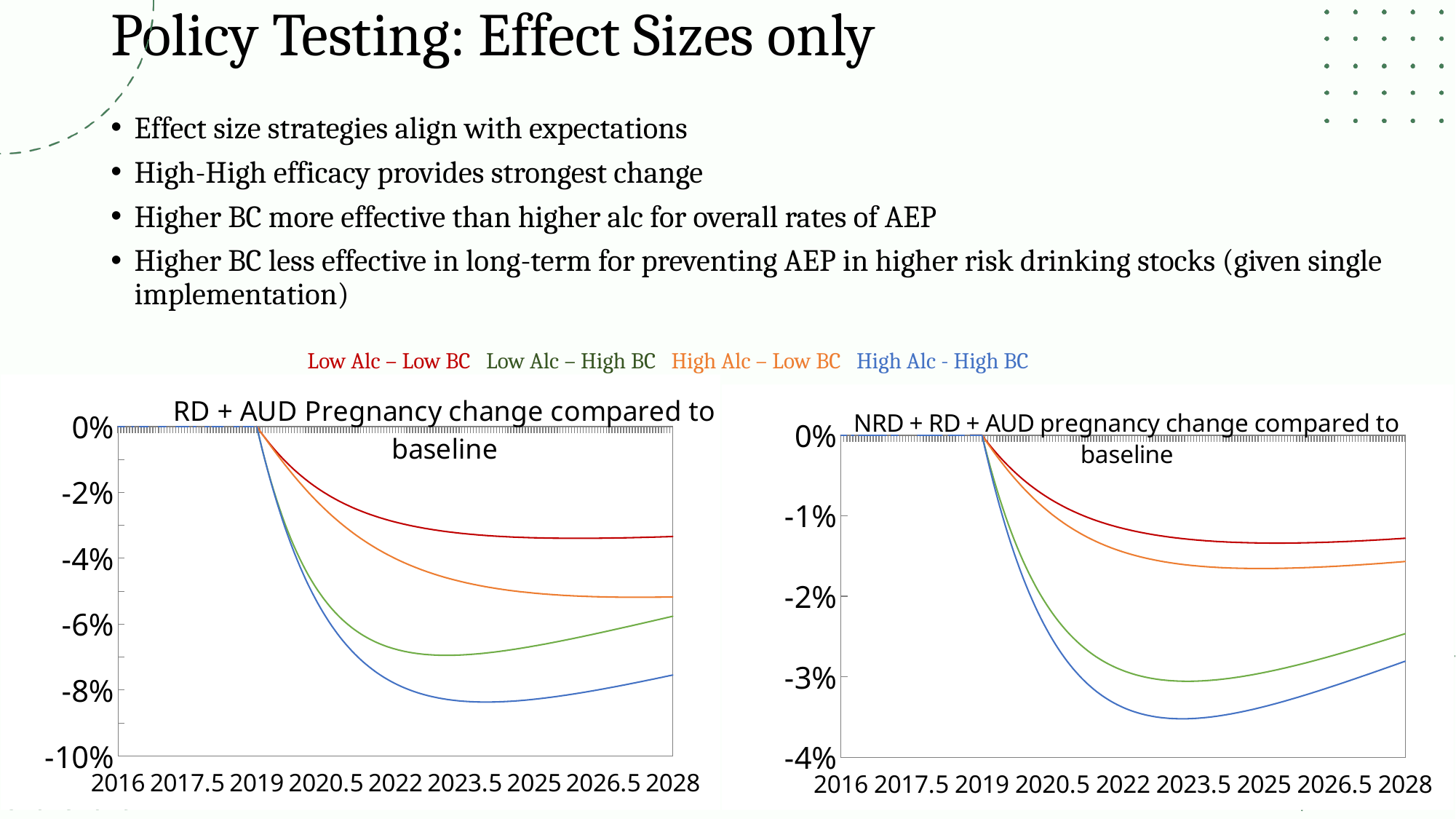
In the right chart 'NRD + RD + AUD pregnancy change compared to baseline', is the lowest point of the High Alc - High BC line greater or less than -3%? less In the left chart 'RD + AUD Pregnancy change compared to baseline', which series reaches the lowest value? High Alc - High BC In the right chart 'NRD + RD + AUD pregnancy change compared to baseline', which series stays closest to 0% throughout? Low Alc – Low BC What kind of chart is the left chart, 'RD + AUD Pregnancy change compared to baseline'? line chart How many year labels are shown on the x axis of the left chart 'RD + AUD Pregnancy change compared to baseline'? 9 What colour is the Low Alc – Low BC series in the legend? red In the right chart 'NRD + RD + AUD pregnancy change compared to baseline', does the High Alc - High BC line rise or fall between 2023.5 and 2028? rise In the left chart 'RD + AUD Pregnancy change compared to baseline', is the lowest point of the High Alc - High BC line greater or less than -8%? less In the right chart 'NRD + RD + AUD pregnancy change compared to baseline', is the value for High Alc – Low BC in 2028 greater or less than -1%? less In the left chart 'RD + AUD Pregnancy change compared to baseline', which series is lower in 2028: Low Alc – High BC or High Alc – Low BC? Low Alc – High BC How many series does the shared legend above the charts list? 4